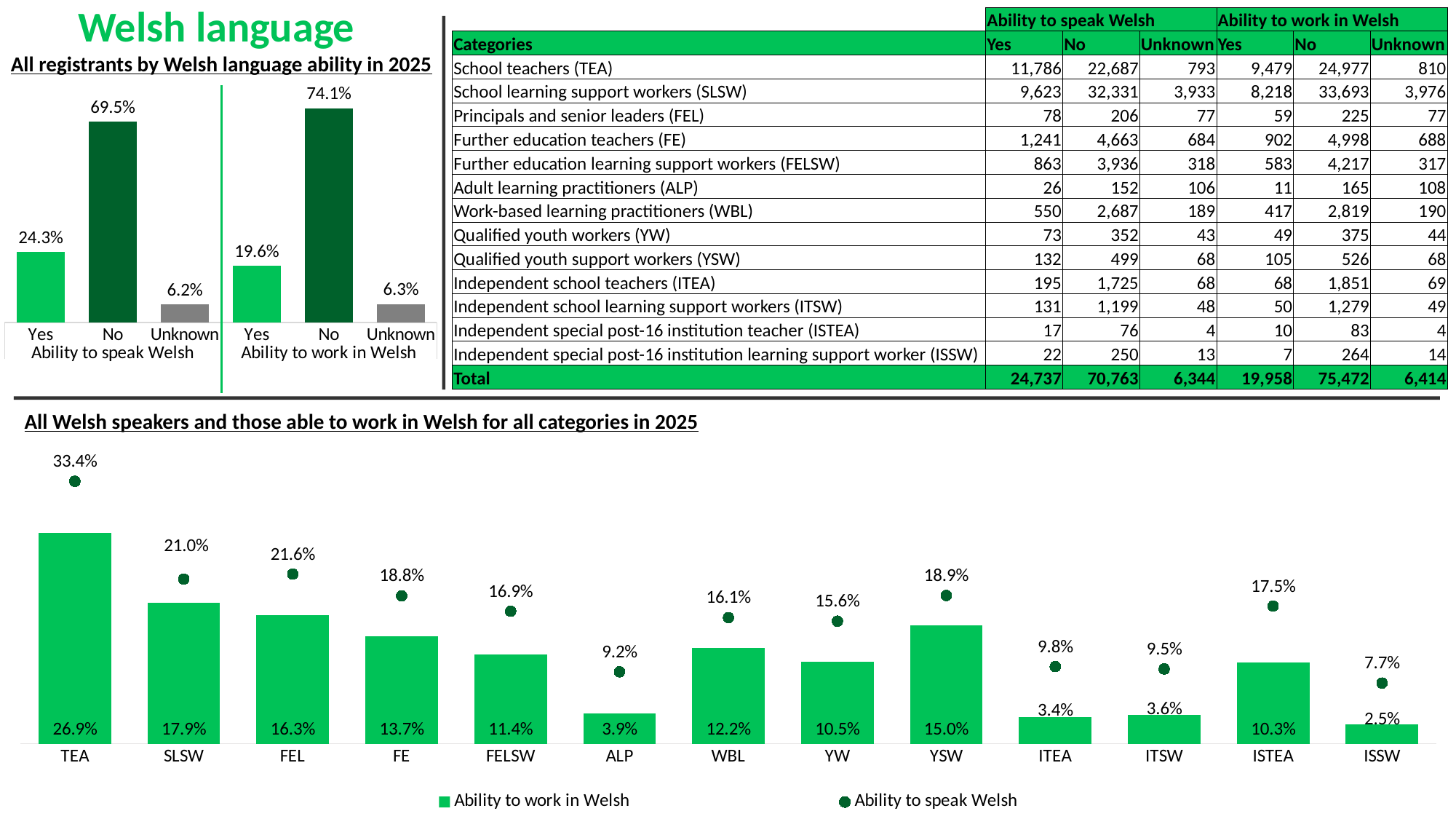
In the chart 'All Welsh speakers and those able to work in Welsh for all categories in 2025', what is the difference in percentage points between ability to speak Welsh and ability to work in Welsh for TEA? 6.5 percentage points In the chart 'All Welsh speakers and those able to work in Welsh for all categories in 2025', what is the ability to work in Welsh value for WBL? 12.2% In the chart 'All registrants by Welsh language ability in 2025', what kind of chart is used? Bar chart In the chart 'All Welsh speakers and those able to work in Welsh for all categories in 2025', how many categories are shown on the x axis? 13 In the chart 'All Welsh speakers and those able to work in Welsh for all categories in 2025', how many series does the legend list? 2 In the chart 'All Welsh speakers and those able to work in Welsh for all categories in 2025', which category has the highest ability to work in Welsh? TEA In the chart 'All Welsh speakers and those able to work in Welsh for all categories in 2025', what is the ability to speak Welsh value for YSW? 18.9% In the chart 'All registrants by Welsh language ability in 2025', what percentage of registrants answered 'Yes' for ability to work in Welsh? 19.6% In the chart 'All Welsh speakers and those able to work in Welsh for all categories in 2025', which has the higher ability to speak Welsh value, FEL or SLSW? FEL In the chart 'All registrants by Welsh language ability in 2025', what percentage of registrants answered 'No' for ability to speak Welsh? 69.5% In the chart 'All registrants by Welsh language ability in 2025', how many percentage points higher is the 'No' value for ability to work in Welsh than the 'No' value for ability to speak Welsh? 4.6 percentage points In the chart 'All Welsh speakers and those able to work in Welsh for all categories in 2025', which category has the lowest ability to speak Welsh? ISSW